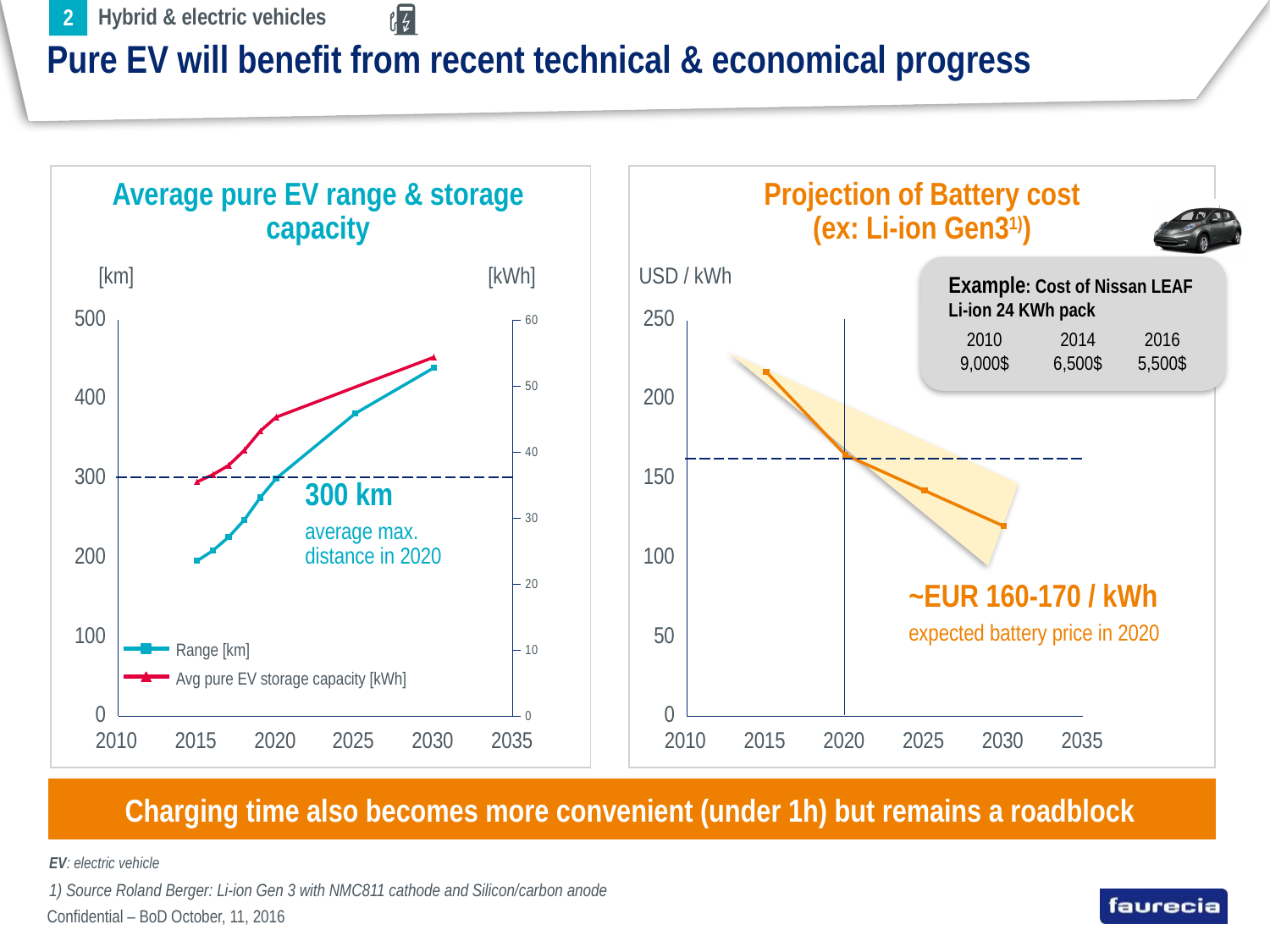
In the left chart 'Average pure EV range & storage capacity', is the Range [km] value for 2015 greater or less than 300? less In the left chart 'Average pure EV range & storage capacity', does the Range [km] series rise or fall from 2015 to 2030? Rise In the right chart 'Projection of Battery cost', is the value for 2015 greater or less than 200? greater In the right chart 'Projection of Battery cost', does the battery cost rise or fall from 2015 to 2030? Fall What kind of chart is the left chart titled 'Average pure EV range & storage capacity'? Line chart How many series does the legend of the left chart 'Average pure EV range & storage capacity' list? 2 In the example box on the right chart 'Projection of Battery cost', by how much did the cost of the Nissan LEAF Li-ion 24 kWh pack fall from 2010 to 2016? 3,500$ In the left chart 'Average pure EV range & storage capacity', is the Range [km] value for 2030 greater or less than 400? greater In the example box on the right chart 'Projection of Battery cost', what was the cost of the Nissan LEAF Li-ion 24 kWh pack in 2016? 5,500$ According to the annotation on the left chart 'Average pure EV range & storage capacity', what is the average max distance in 2020? 300 km According to the annotation on the right chart 'Projection of Battery cost', what is the expected battery price in 2020? ~EUR 160-170 / kWh